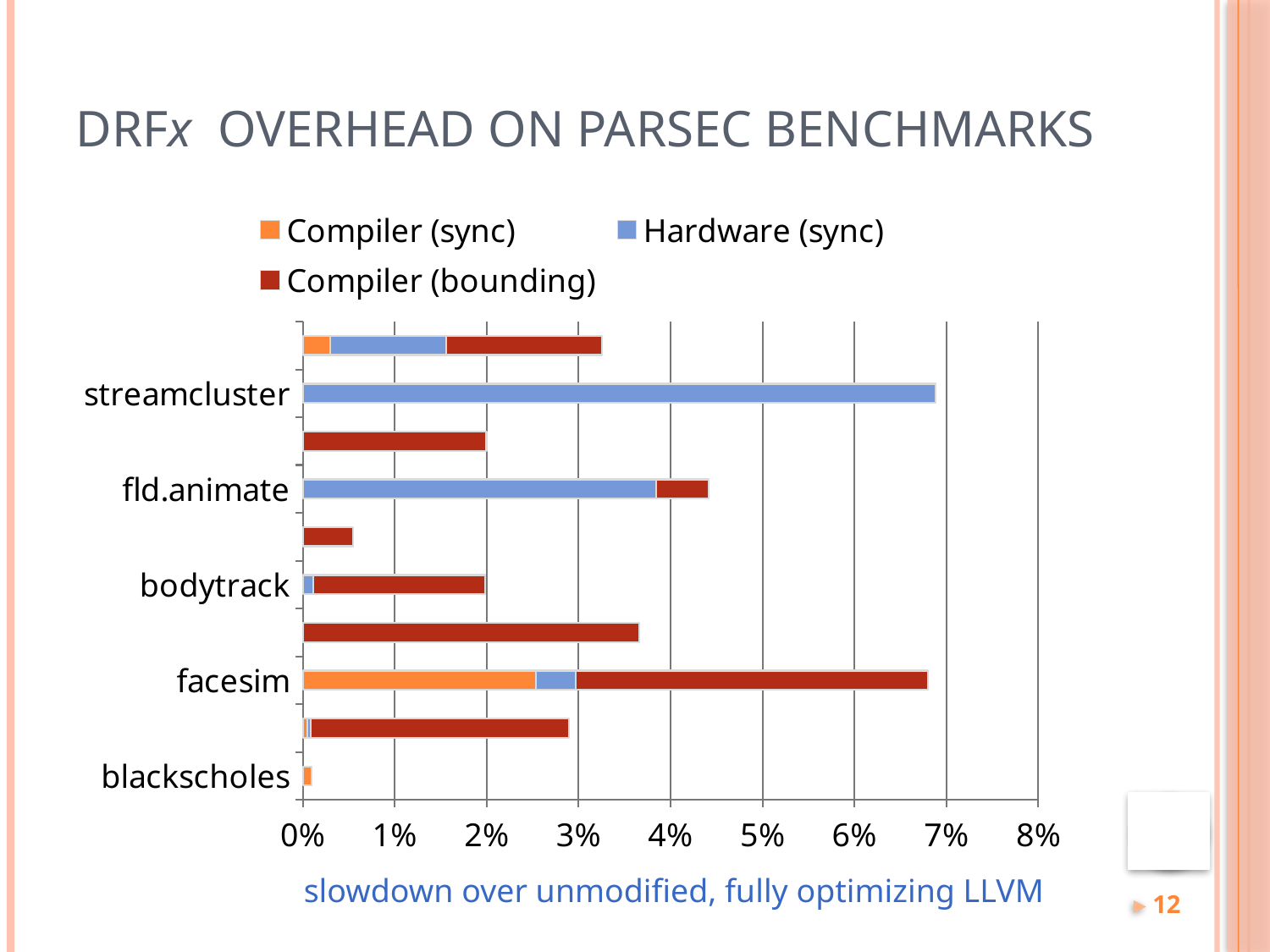
Which series are listed in the legend? Compiler (sync), Hardware (sync), Compiler (bounding) What is the label on the x axis of the chart? slowdown over unmodified, fully optimizing LLVM What kind of chart is shown on the slide? bar chart Which has the larger total slowdown, the facesim bar or the bodytrack bar? facesim How many series does the legend list? 3 Is the total slowdown for the fld.animate bar greater or less than 4%? greater Among the labeled benchmarks, which has the lowest total slowdown? blackscholes Which has the larger total slowdown, the streamcluster bar or the fld.animate bar? streamcluster Is the total slowdown for the bodytrack bar greater or less than 3%? less Is the total slowdown for the blackscholes bar greater or less than 1%? less